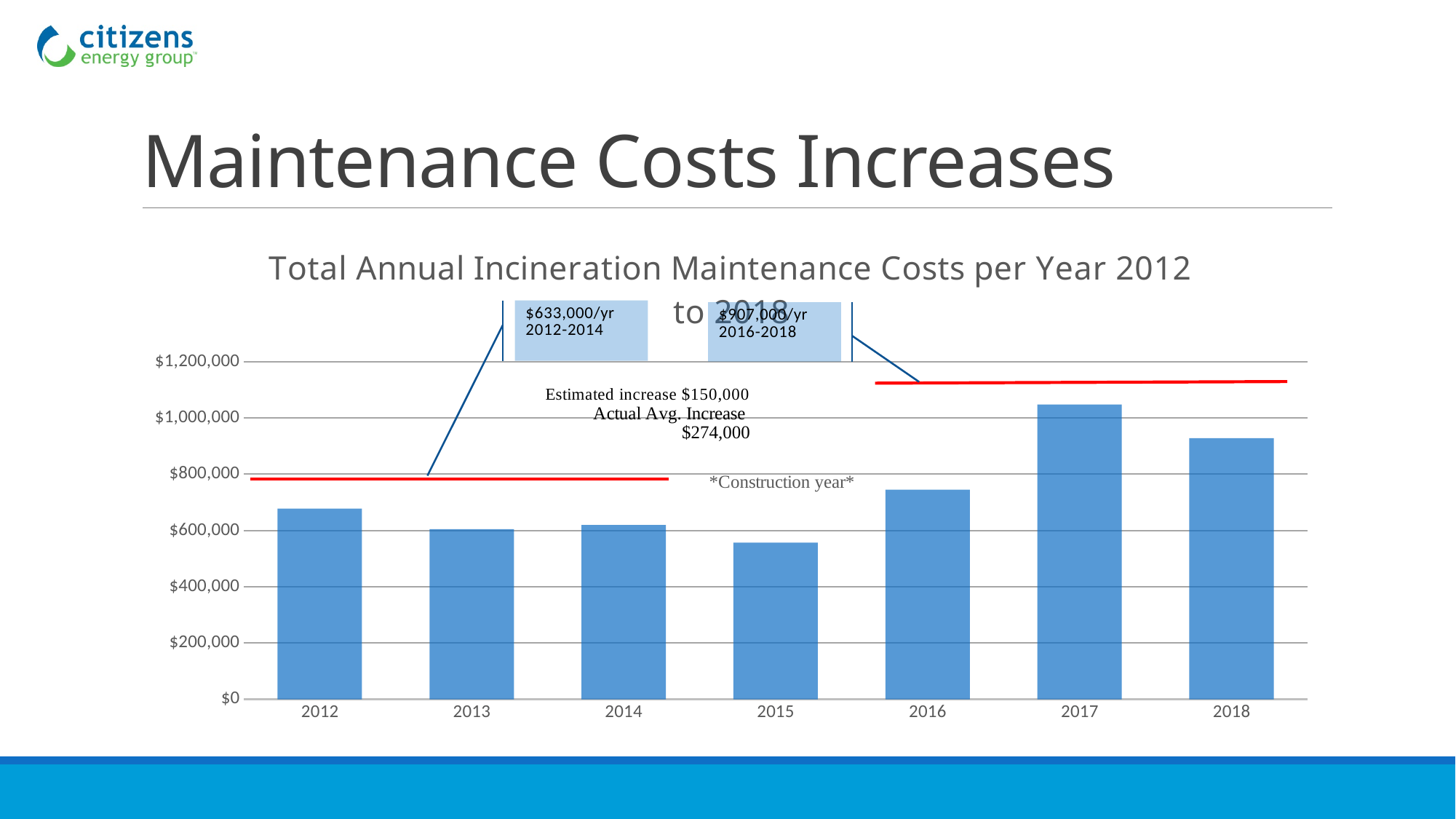
How many years are plotted on the x axis of the chart? 7 Which year has the lowest maintenance cost in the chart? 2015 Is the value for 2016 greater or less than $800,000? less Is the value for 2015 greater or less than $600,000? less Is the value for 2018 greater or less than $1,000,000? less Which year has the highest maintenance cost in the chart? 2017 Do the maintenance costs rise or fall from 2015 to 2017? rise What is the title of the chart? Total Annual Incineration Maintenance Costs per Year 2012 to 2018 Which year has the larger maintenance cost, 2017 or 2018? 2017 What kind of chart is shown on the slide? bar chart